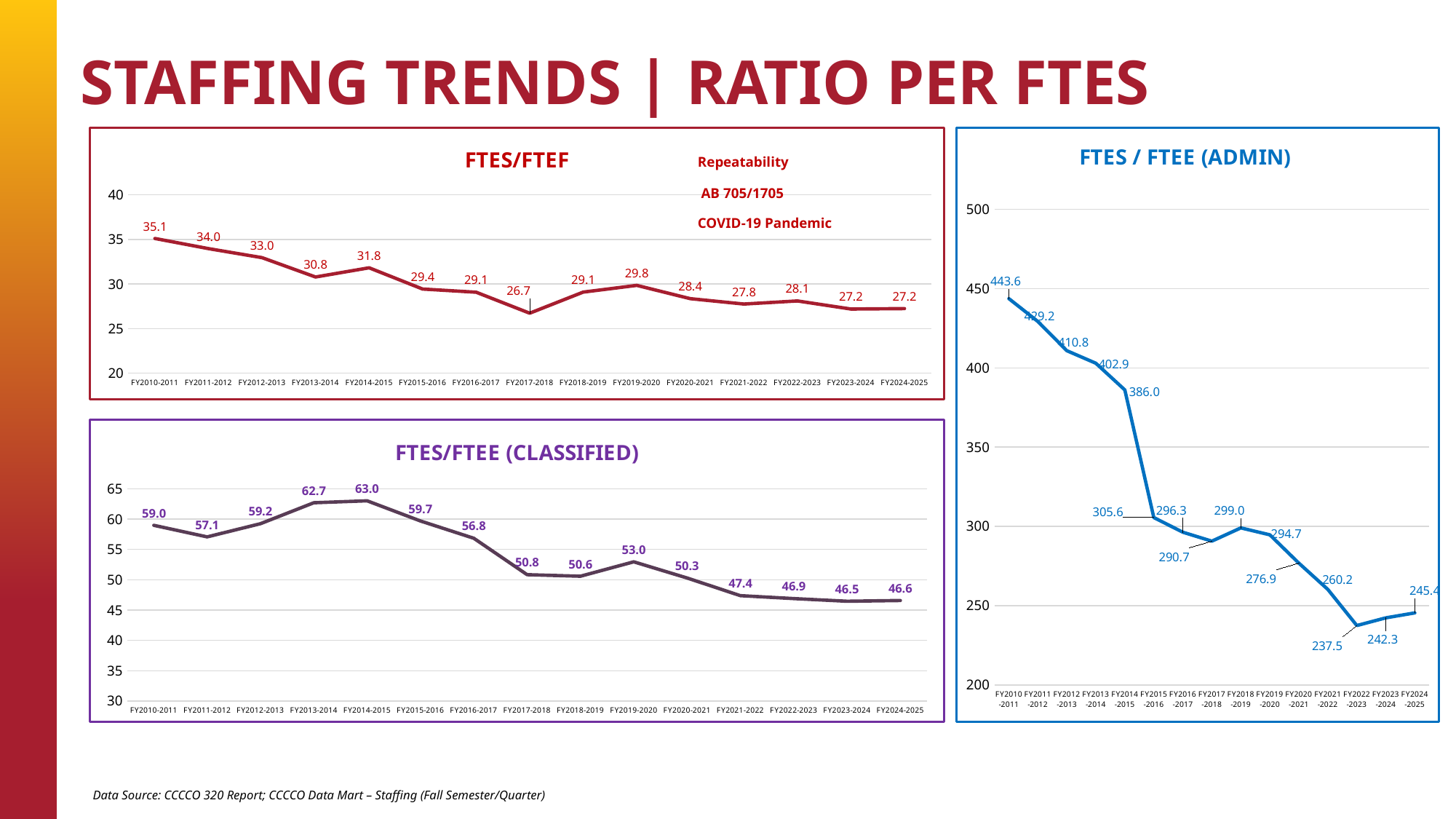
In the FTES / FTEE (ADMIN) chart, what is the difference between the FY2010-2011 value and the FY2024-2025 value? 198.2 What kind of chart is the FTES/FTEE (CLASSIFIED) chart? Line chart In the FTES / FTEE (ADMIN) chart, do the values generally rise or fall from FY2010-2011 to FY2024-2025? Fall In the FTES / FTEE (ADMIN) chart, what is the value for FY2015-2016? 305.6 In the FTES/FTEF chart, which fiscal year has the lowest value? FY2017-2018 In the FTES/FTEF chart, what is the difference between the FY2010-2011 value and the FY2024-2025 value? 7.9 In the FTES/FTEE (CLASSIFIED) chart, which fiscal year has the highest value? FY2014-2015 In the FTES/FTEF chart, what is the value for FY2010-2011? 35.1 In the FTES/FTEE (CLASSIFIED) chart, which is larger, the value for FY2019-2020 or the value for FY2020-2021? FY2019-2020 How many fiscal years are plotted in the FTES / FTEE (ADMIN) chart? 15 In the FTES/FTEE (CLASSIFIED) chart, what is the value for FY2014-2015? 63.0 In the FTES / FTEE (ADMIN) chart, which fiscal year has the lowest value? FY2022-2023